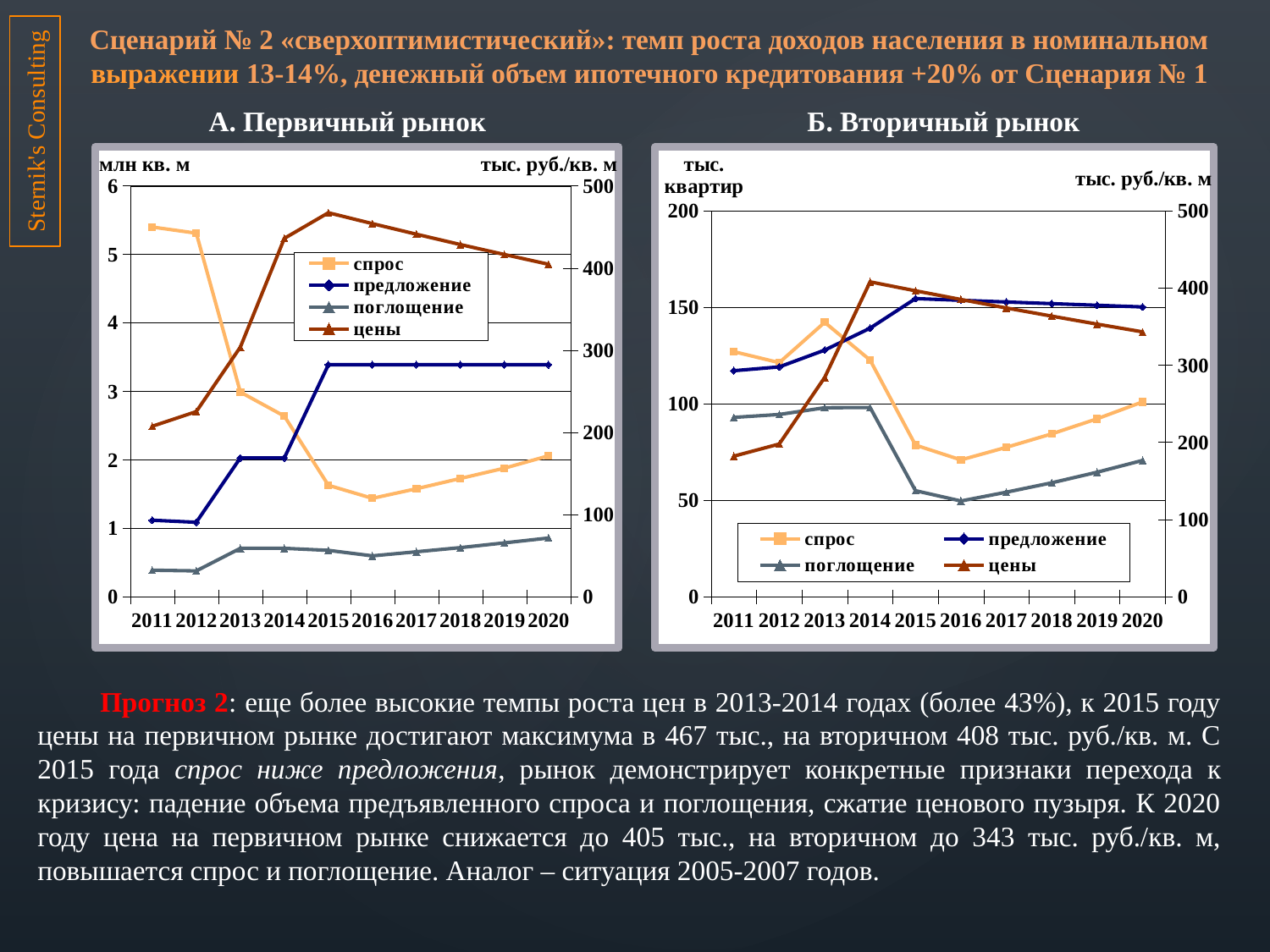
What kind of chart is used for "А. Первичный рынок"? line chart In the "А. Первичный рынок" chart, which is larger in 2011: спрос or предложение? спрос How many series does the legend of the "Б. Вторичный рынок" chart list? 4 What unit label is shown on the right-hand axis of the "Б. Вторичный рынок" chart? тыс. руб./кв. м In the "Б. Вторичный рынок" chart, is the value for спрос in 2013 greater or less than 100? greater How many years are shown on the x axis of the "А. Первичный рынок" chart? 10 In the "А. Первичный рынок" chart, is the value for спрос in 2011 greater or less than 5? greater In the "А. Первичный рынок" chart, do цены rise or fall from 2015 to 2020? fall In the "А. Первичный рынок" chart, is the value for поглощение in 2011 greater or less than 1? less In the "А. Первичный рынок" chart, in which year is спрос at its lowest? 2016 In the "А. Первичный рынок" chart, in which year do цены reach their highest value? 2015 In the "Б. Вторичный рынок" chart, in which year do цены reach their highest value? 2014